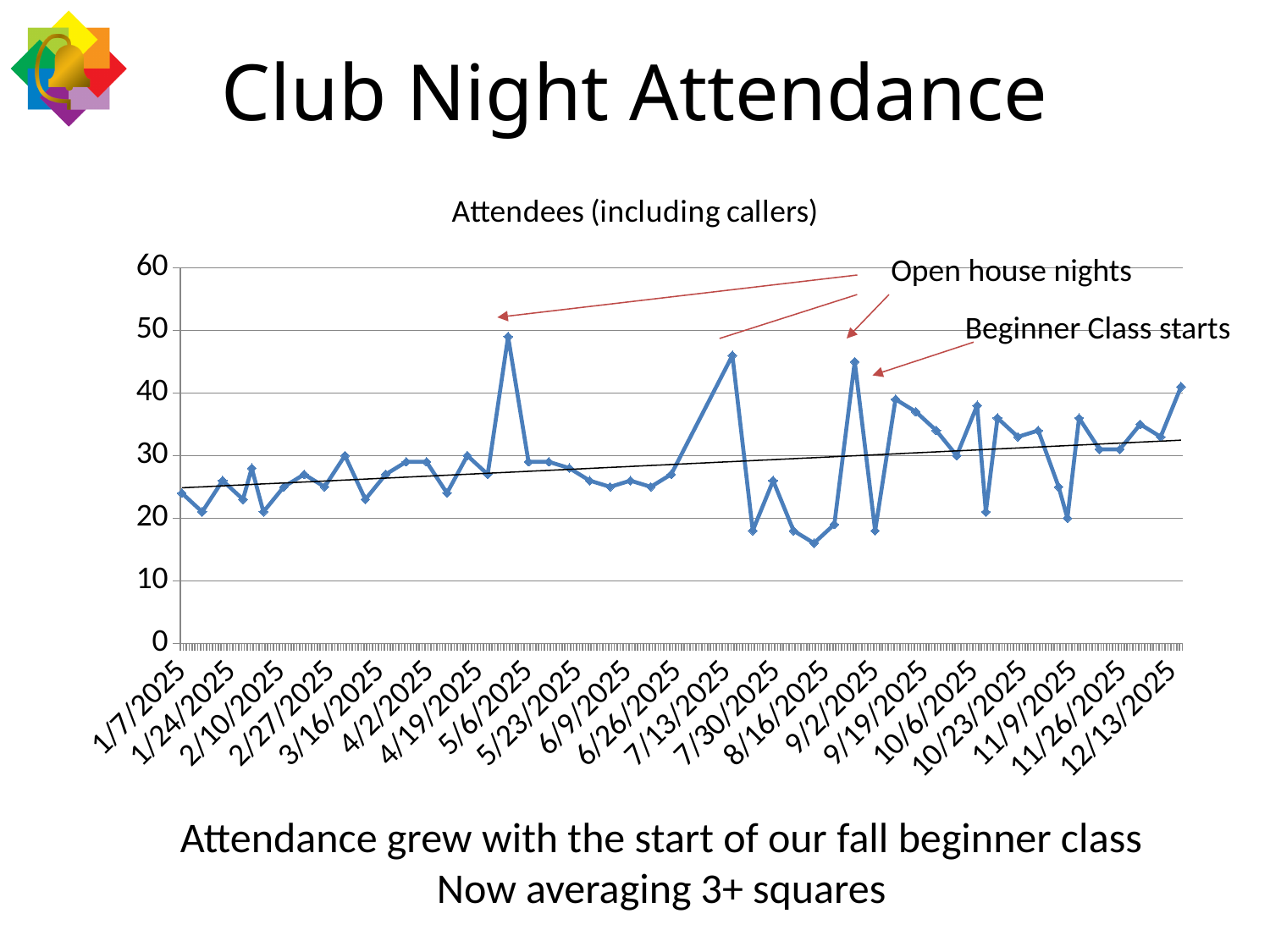
Is the attendance value at 12/13/2025 greater or less than 30? greater What is the title of the chart? Attendees (including callers) Is the highest point on the line greater or less than 40? greater Does the straight trend line rise or fall from left to right across the chart? rises What kind of chart is shown on the slide? line chart What is the highest value shown on the vertical axis? 60 Which is larger, the attendance at 5/6/2025 or the attendance at 8/16/2025? 5/6/2025 Is the attendance value at 8/16/2025 greater or less than 20? less